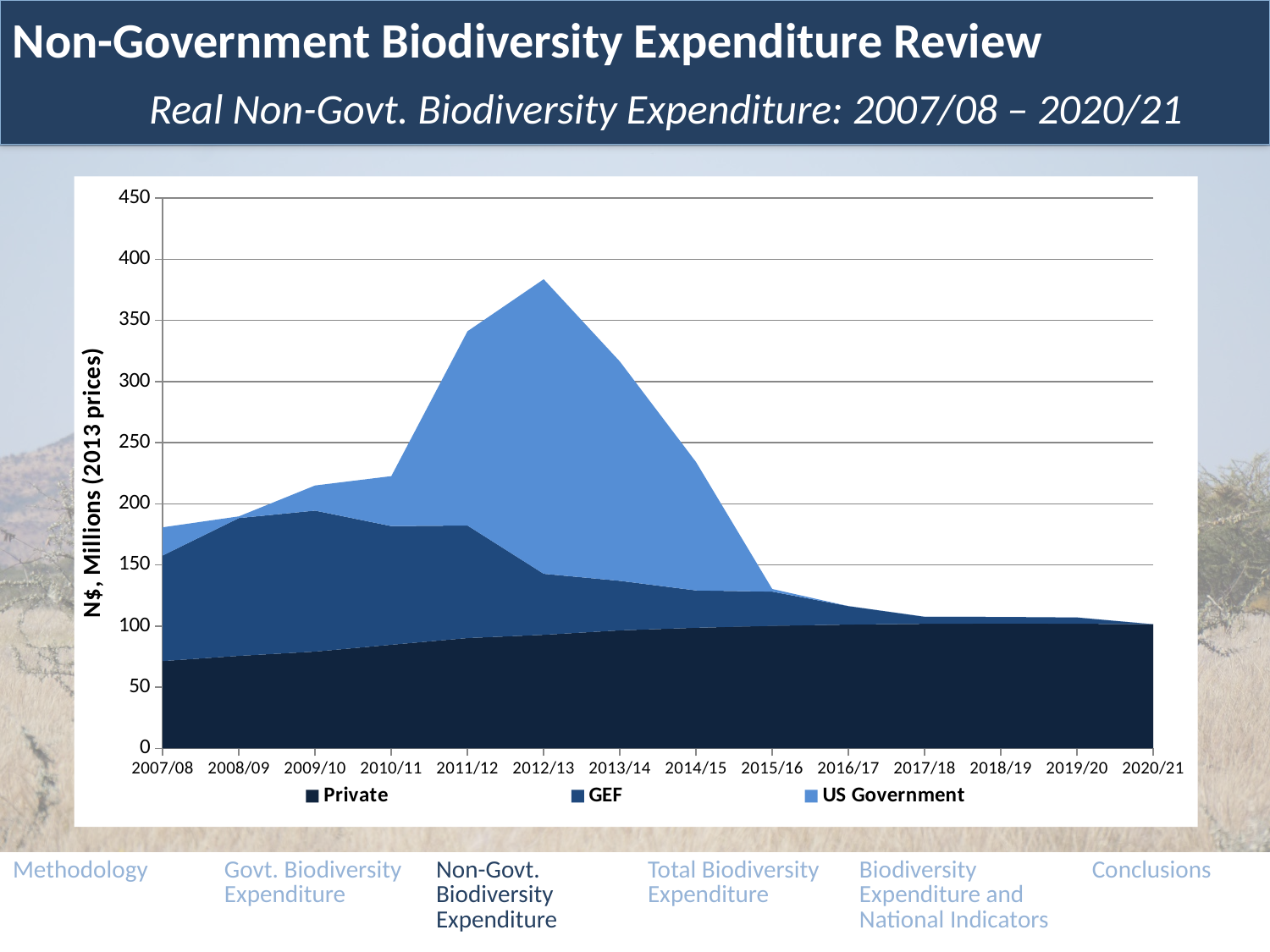
Which series is shown at the bottom of the stack in the darkest colour? Private Which is larger, the total expenditure in 2012/13 or in 2007/08? 2012/13 In which year does the total non-government biodiversity expenditure reach its highest point? 2012/13 What is the label on the y axis? N$, Millions (2013 prices) Is the Private expenditure in 2007/08 greater or less than 100? less Is the total expenditure in 2020/21 greater or less than 150? less How many fiscal years are plotted along the x axis? 14 Does the total expenditure rise or fall from 2015/16 to 2020/21? Fall Is the total expenditure in 2007/08 greater or less than 150? greater What kind of chart is shown on the slide? Stacked area chart How many series does the legend list? 3